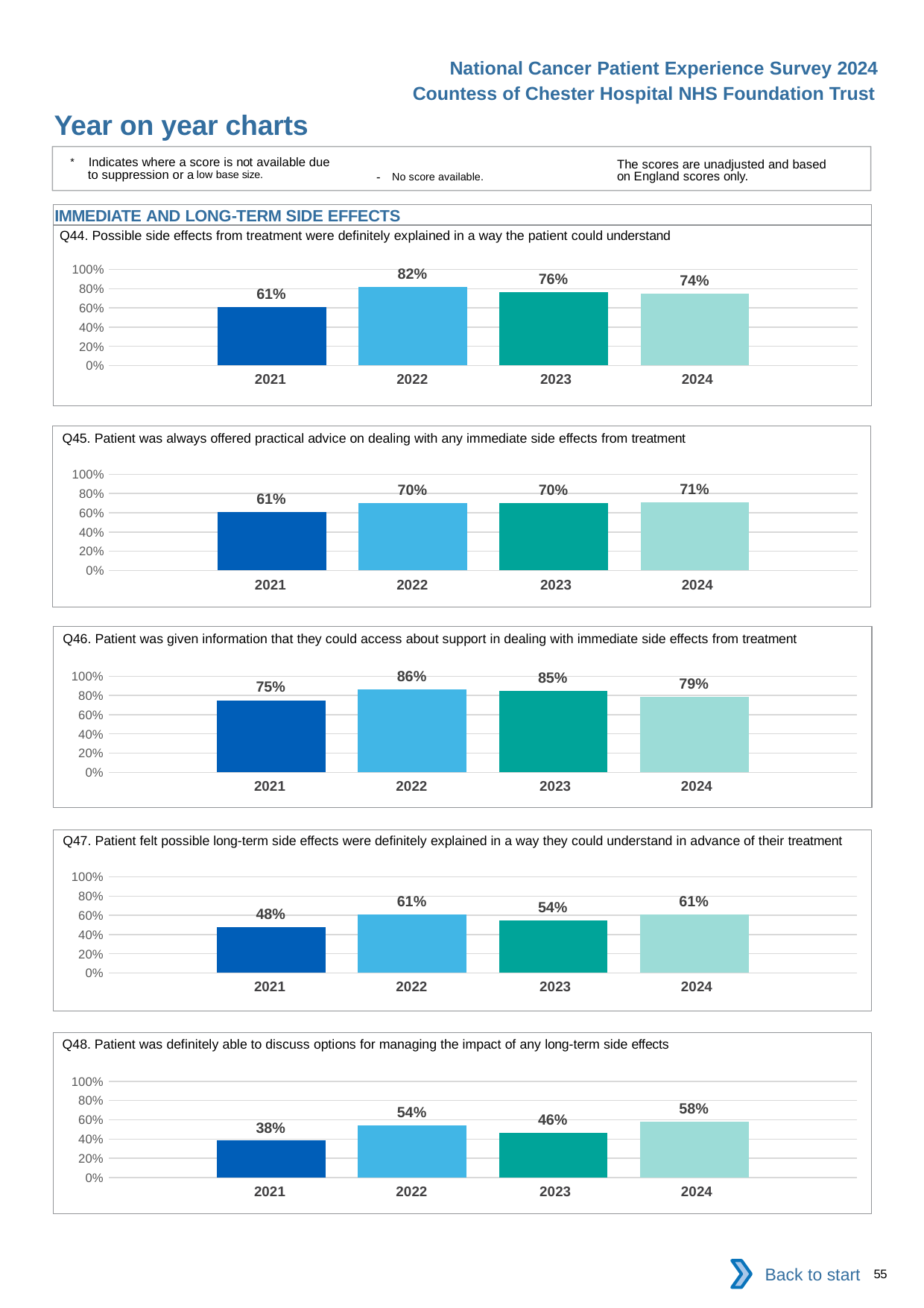
In the Q46 chart, what is the value for 2024? 79% In the Q45 chart, what is the difference between the 2024 value and the 2021 value? 10 percentage points In the Q46 chart, which year has the highest value? 2022 In the Q45 chart, what is the value for 2023? 70% In the Q47 chart, what is the value for 2021? 48% In the Q47 chart, which is larger, the value for 2022 or the value for 2023? 2022 In the Q44 chart, what is the value for 2022? 82% In the Q44 chart, which year has the lowest value? 2021 What kind of chart is the Q44 chart? Bar chart How many years are shown in the Q48 chart? 4 In the Q48 chart, what is the difference between the 2024 value and the 2023 value? 12 percentage points In the Q48 chart, is the value for 2021 greater or less than 40%? less